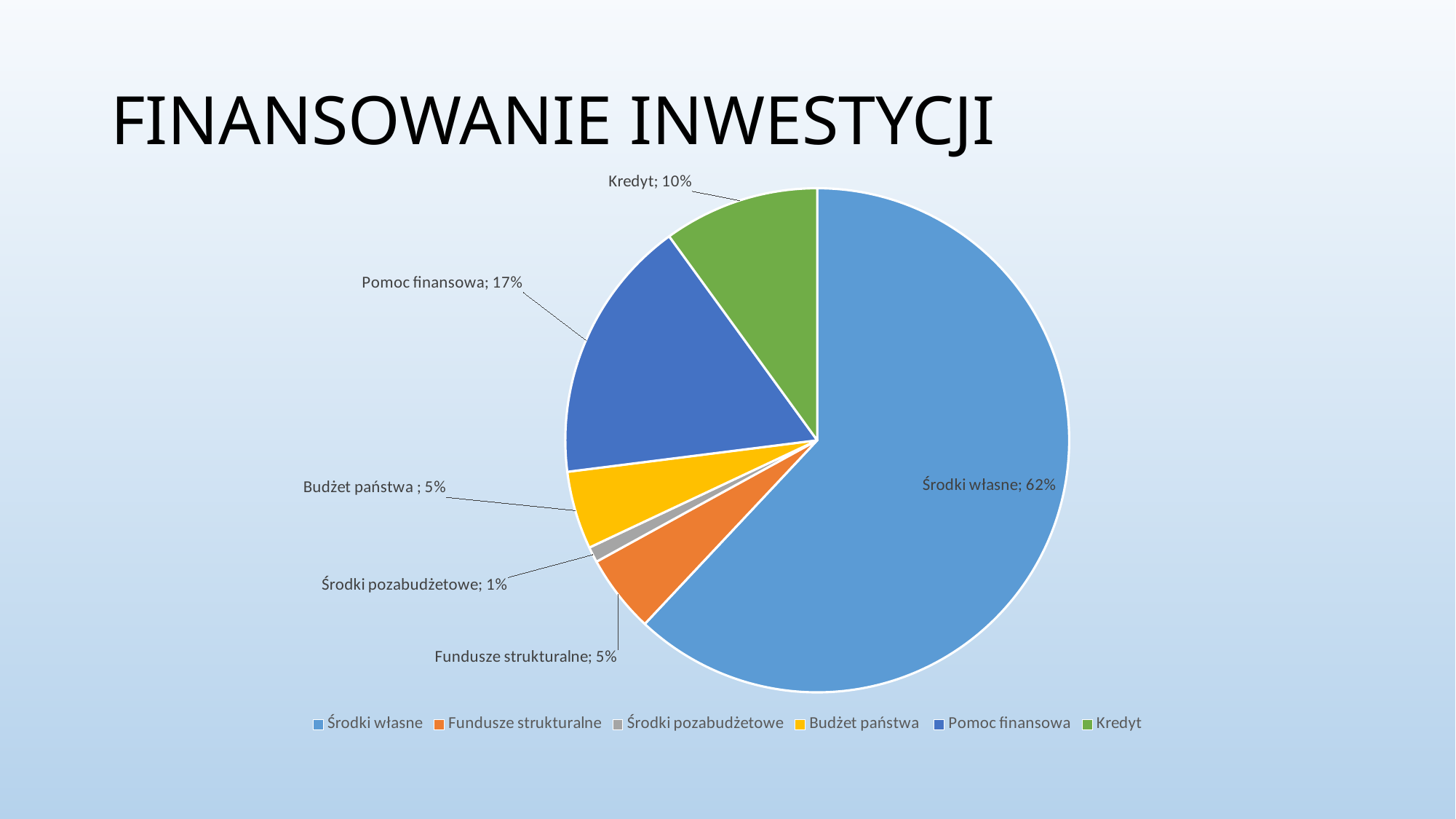
What is the title of the slide? FINANSOWANIE INWESTYCJI What is the value shown for Pomoc finansowa? 17% How many categories are shown in the pie chart? 6 Which category has the smallest slice of the pie? Środki pozabudżetowe What is the difference between the shares of Pomoc finansowa and Kredyt? 7% Which is larger, the share for Kredyt or the share for Budżet państwa? Kredyt What share of the pie does Środki własne represent? 62% What colour is the slice for Kredyt? Green What is the value shown for Kredyt? 10% What kind of chart is shown on the slide? Pie chart Which category has the largest slice of the pie? Środki własne What is the value shown for Środki pozabudżetowe? 1%